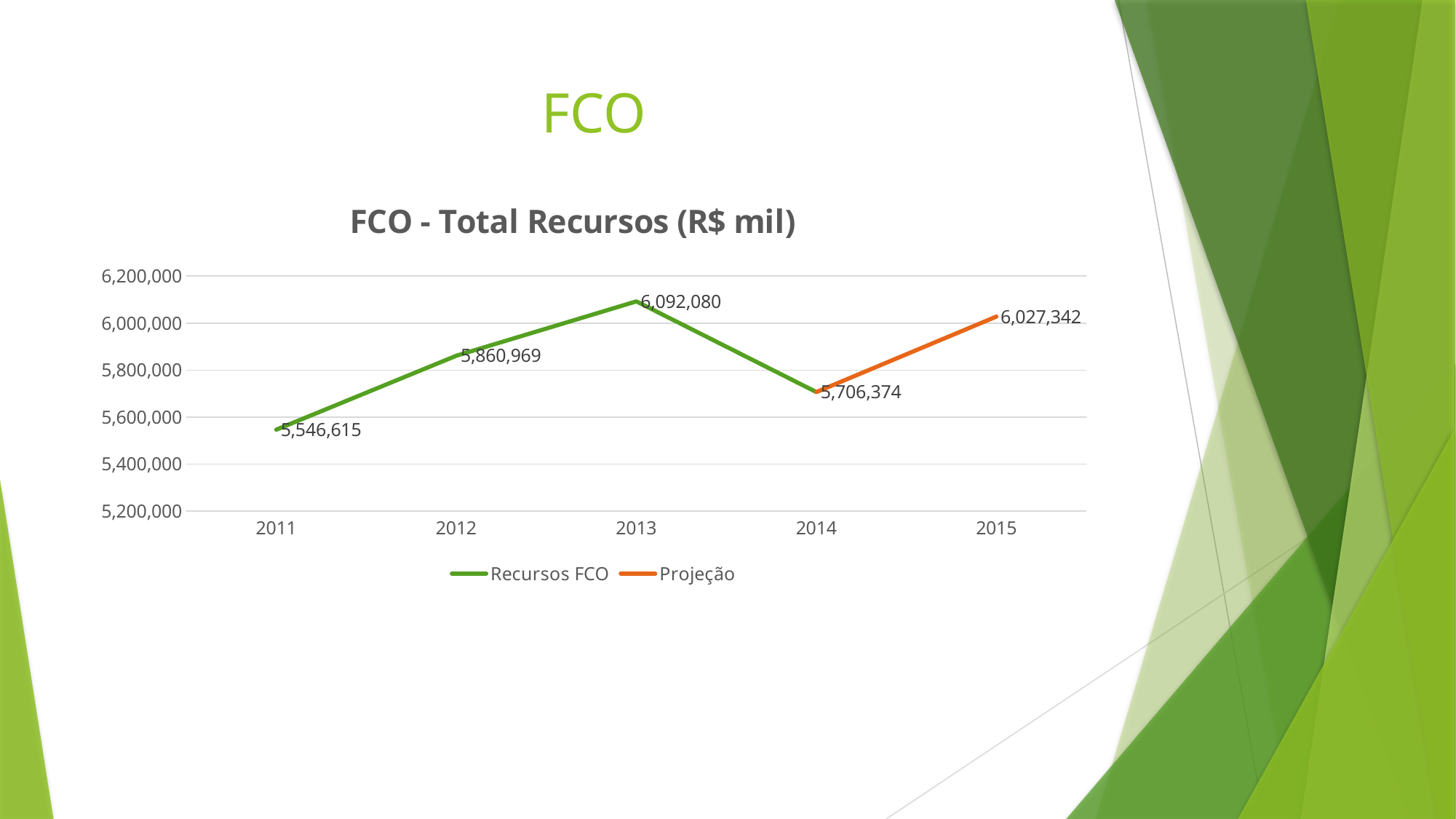
What kind of chart is the FCO - Total Recursos chart? Line chart What is the value for 2013 in the FCO - Total Recursos chart? 6,092,080 What is the difference between the 2015 projected value and the 2014 value in the FCO - Total Recursos chart? 320,968 How many years are shown on the x axis of the FCO - Total Recursos chart? 5 What is the value for 2014 in the FCO - Total Recursos chart? 5,706,374 Which year has the highest value in the FCO - Total Recursos chart? 2013 What is the difference between the 2013 value and the 2011 value in the FCO - Total Recursos chart? 545,465 What is the projected value for 2015 in the FCO - Total Recursos chart? 6,027,342 Which is larger in the FCO - Total Recursos chart, the value for 2012 or the value for 2014? 2012 What is the value for 2011 in the FCO - Total Recursos chart? 5,546,615 How many series does the legend of the FCO - Total Recursos chart list? 2 Which year has the lowest value in the FCO - Total Recursos chart? 2011